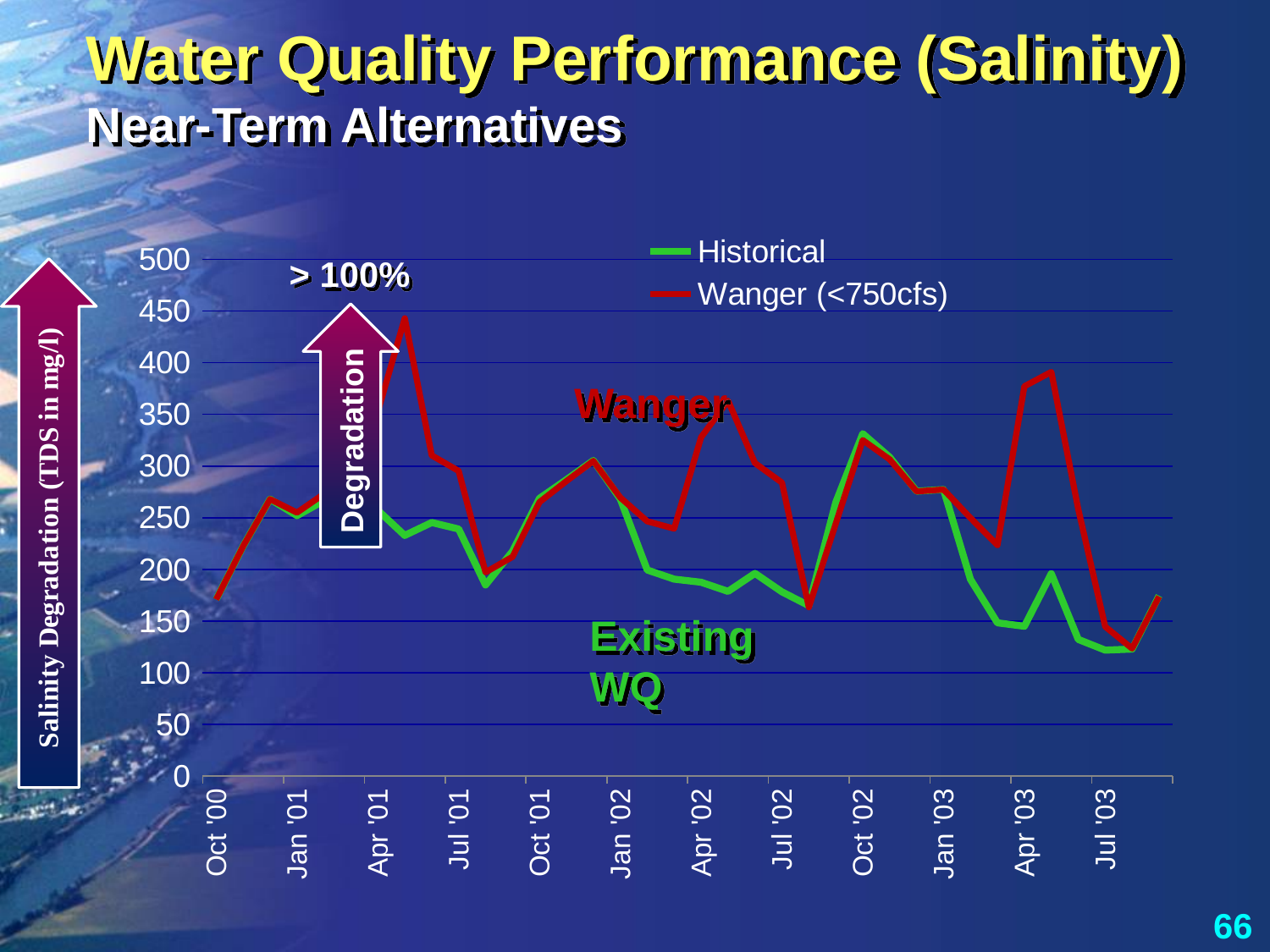
Does the Historical line rise or fall from Oct '02 to Jul '03? Fall At Apr '03, which series has the higher value, Historical or Wanger (<750cfs)? Wanger (<750cfs) Which series reaches the highest peak on the chart? Wanger (<750cfs) What colour is the Historical line? Green How many series does the legend list? 2 What are the two series named in the legend? Historical and Wanger (<750cfs) What kind of chart is shown on the slide? Line chart How many labels are shown on the x axis? 12 Is the Historical value at Oct '02 greater or less than 300? greater Is the Wanger (<750cfs) value at Oct '00 greater or less than 200? less Is the Wanger (<750cfs) value at Apr '02 greater or less than 300? greater